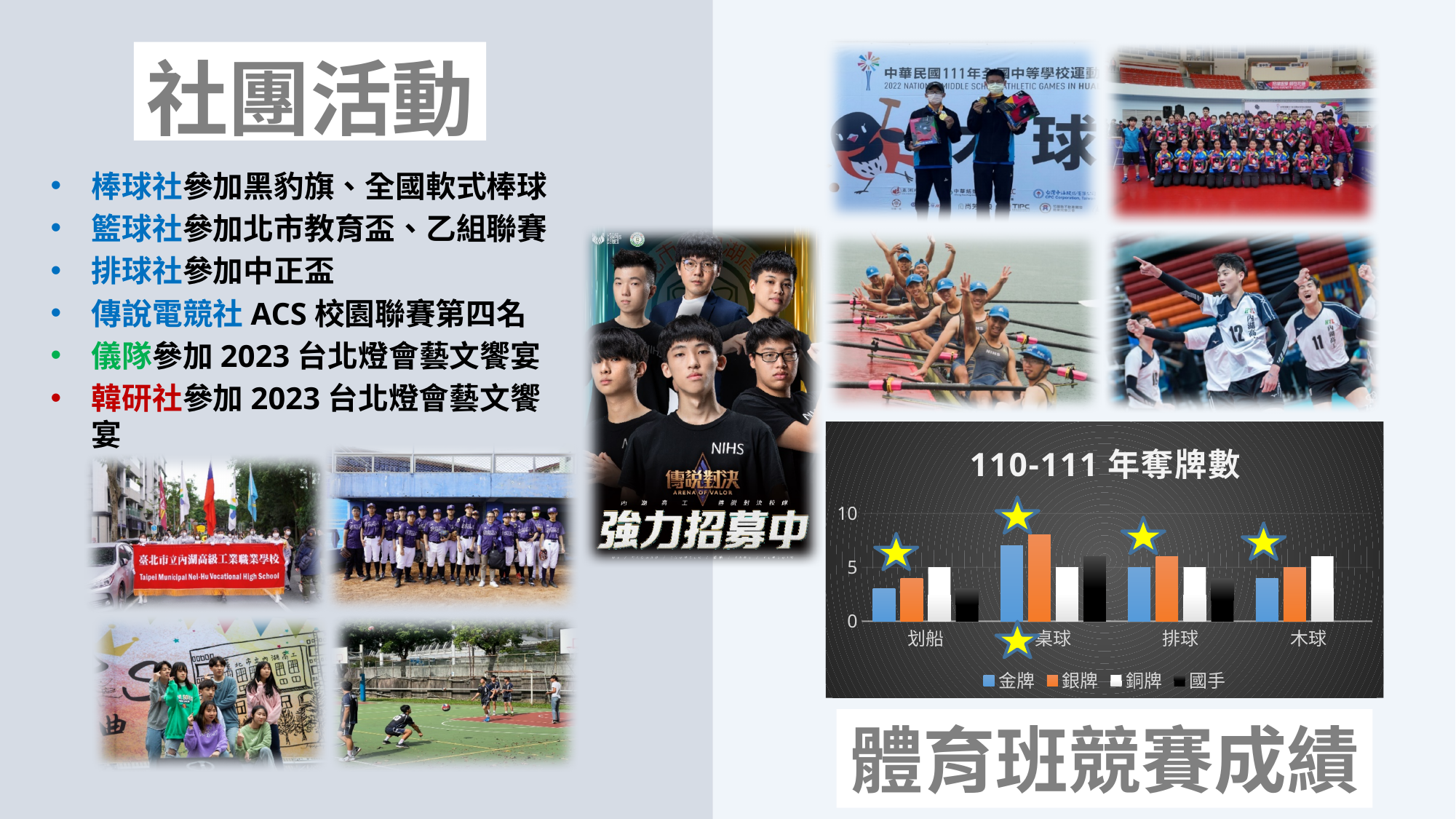
In the 110-111 年奪牌數 chart, which category has the highest 金牌 value? 桌球 What is the title of the chart on the slide? 110-111 年奪牌數 How many categories are shown on the x axis of the 110-111 年奪牌數 chart? 4 In the 110-111 年奪牌數 chart, which is larger: the 銀牌 value for 桌球 or the 銀牌 value for 划船? 桌球 In the 110-111 年奪牌數 chart, is the 銀牌 value for 桌球 greater or less than 5? greater How many series does the legend of the 110-111 年奪牌數 chart list? 4 In the 110-111 年奪牌數 chart, is the 金牌 value for 划船 greater or less than 5? less In the 110-111 年奪牌數 chart, which is larger: the 金牌 value for 排球 or the 金牌 value for 桌球? 桌球 Which series in the 110-111 年奪牌數 chart is shown in orange? 銀牌 What kind of chart is the 110-111 年奪牌數 chart? bar chart In the 110-111 年奪牌數 chart, which category has the highest 國手 value? 桌球